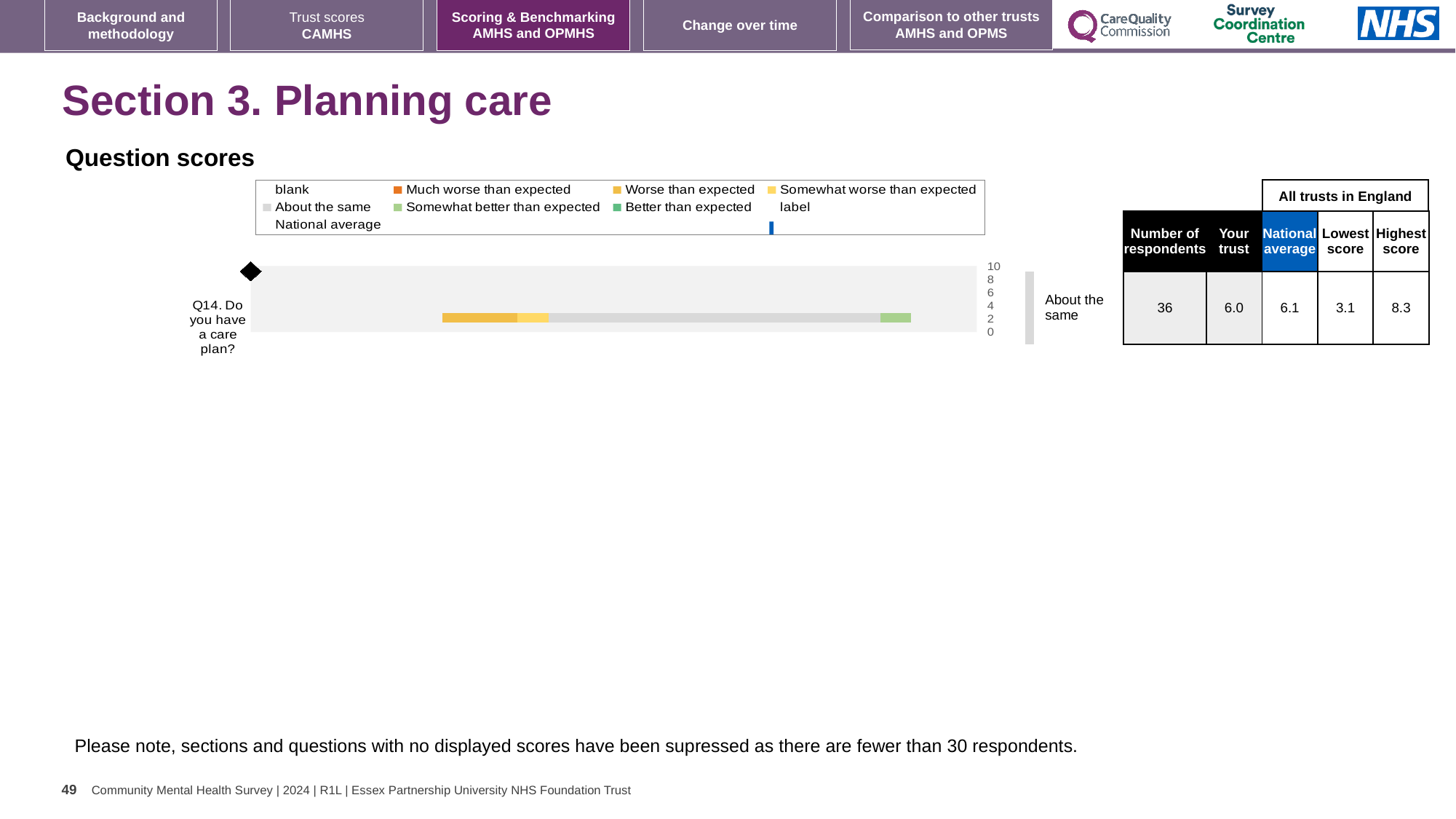
For Q14, which is larger: the trust's score or the national average? National average What is the lowest score among all trusts in England for Q14? 3.1 What is the label of the question plotted in the chart? Q14. Do you have a care plan? What is the national average score for Q14? 6.1 How many respondents answered Q14? 36 What kind of chart is used to show the Q14 question score? bar chart What is the difference between the national average and the trust's score for Q14? 0.1 What is the highest score among all trusts in England for Q14? 8.3 What is the 'Your trust' score for Q14 in the table beside the chart? 6.0 Which benchmark category is shown next to the bar for Q14? About the same How many questions are plotted in the chart? 1 What is the difference between the highest and lowest scores for Q14 across all trusts in England? 5.2